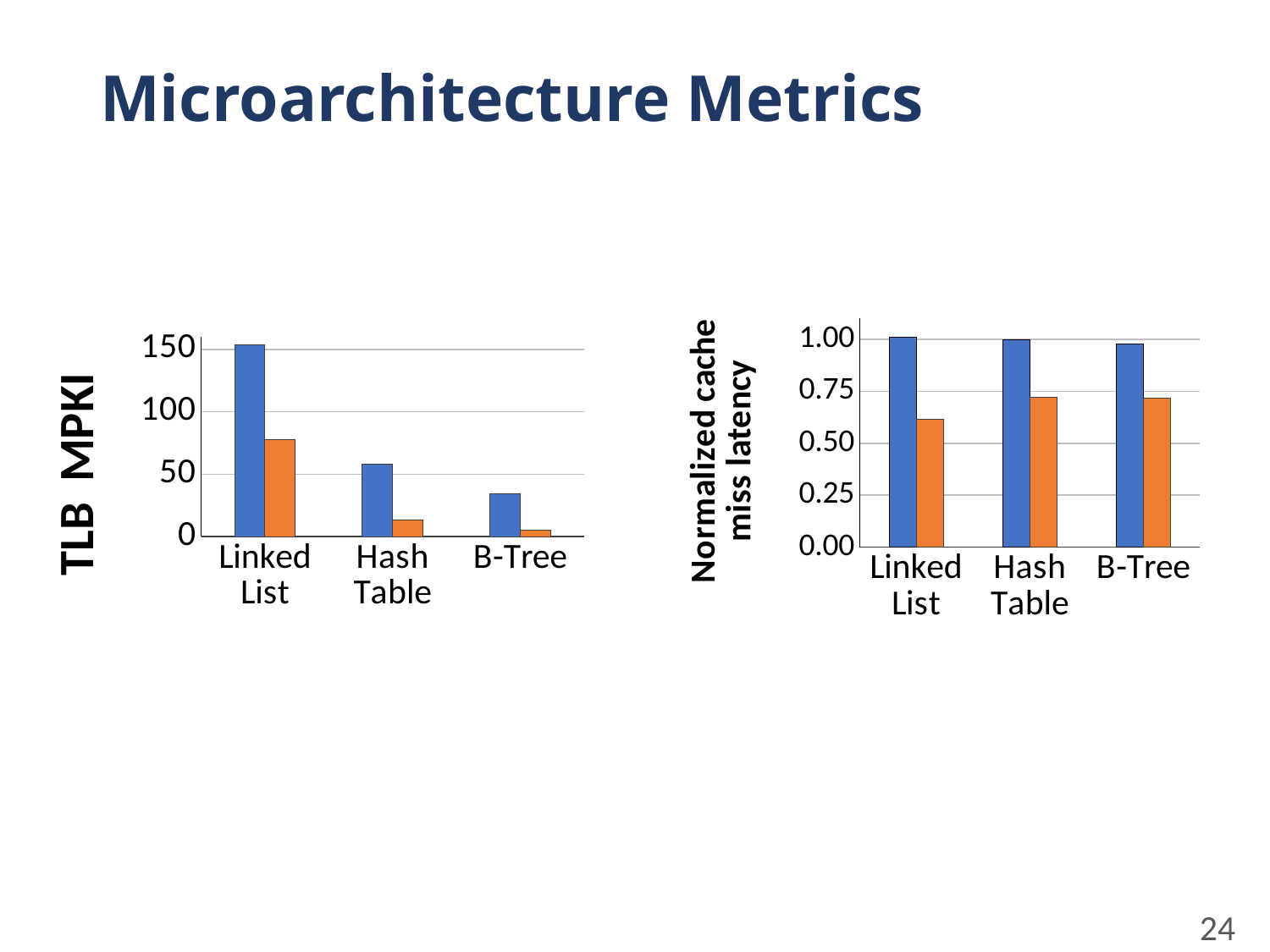
In the left chart (TLB MPKI), is the blue bar for Linked List greater or less than 100? greater In the right chart (Normalized cache miss latency), is the blue bar for Hash Table greater or less than 0.75? greater In the left chart (TLB MPKI), which is larger for Linked List, the blue bar or the orange bar? the blue bar In the left chart (TLB MPKI), which category has the tallest blue bar? Linked List What is the y-axis label of the right chart? Normalized cache miss latency What kind of chart is the left chart (TLB MPKI)? bar chart In the left chart (TLB MPKI), do the blue bars rise or fall from Linked List to B-Tree? fall In the left chart (TLB MPKI), is the orange bar for Hash Table greater or less than 50? less How many categories are shown on the x axis of the left chart (TLB MPKI)? 3 In the right chart (Normalized cache miss latency), which category has the lowest orange bar? Linked List